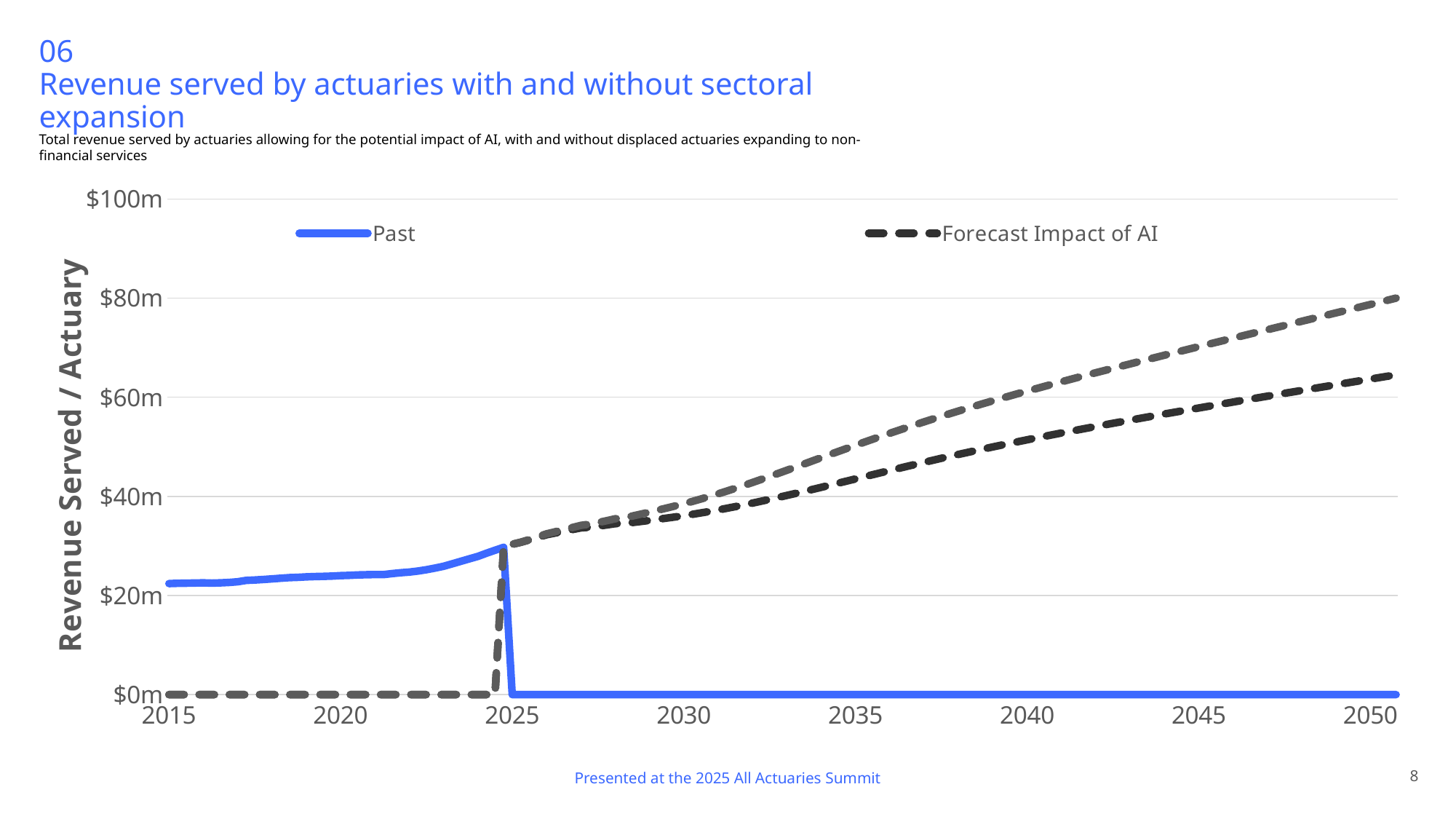
What kind of chart is shown on the slide? line chart How many series does the chart legend list? 2 What are the two entries in the chart legend? Past; Forecast Impact of AI Is the value of the Past series in 2020 greater or less than $20m? greater What is the title of the vertical axis? Revenue Served / Actuary Do the Forecast Impact of AI lines rise or fall between 2025 and 2050? rise How many year labels are shown on the horizontal axis? 8 Is the value of the lower Forecast Impact of AI line in 2040 greater or less than $60m? less Is the value of the upper Forecast Impact of AI line in 2050 greater or less than $60m? greater Does the Past series rise or fall between 2015 and 2025? rise